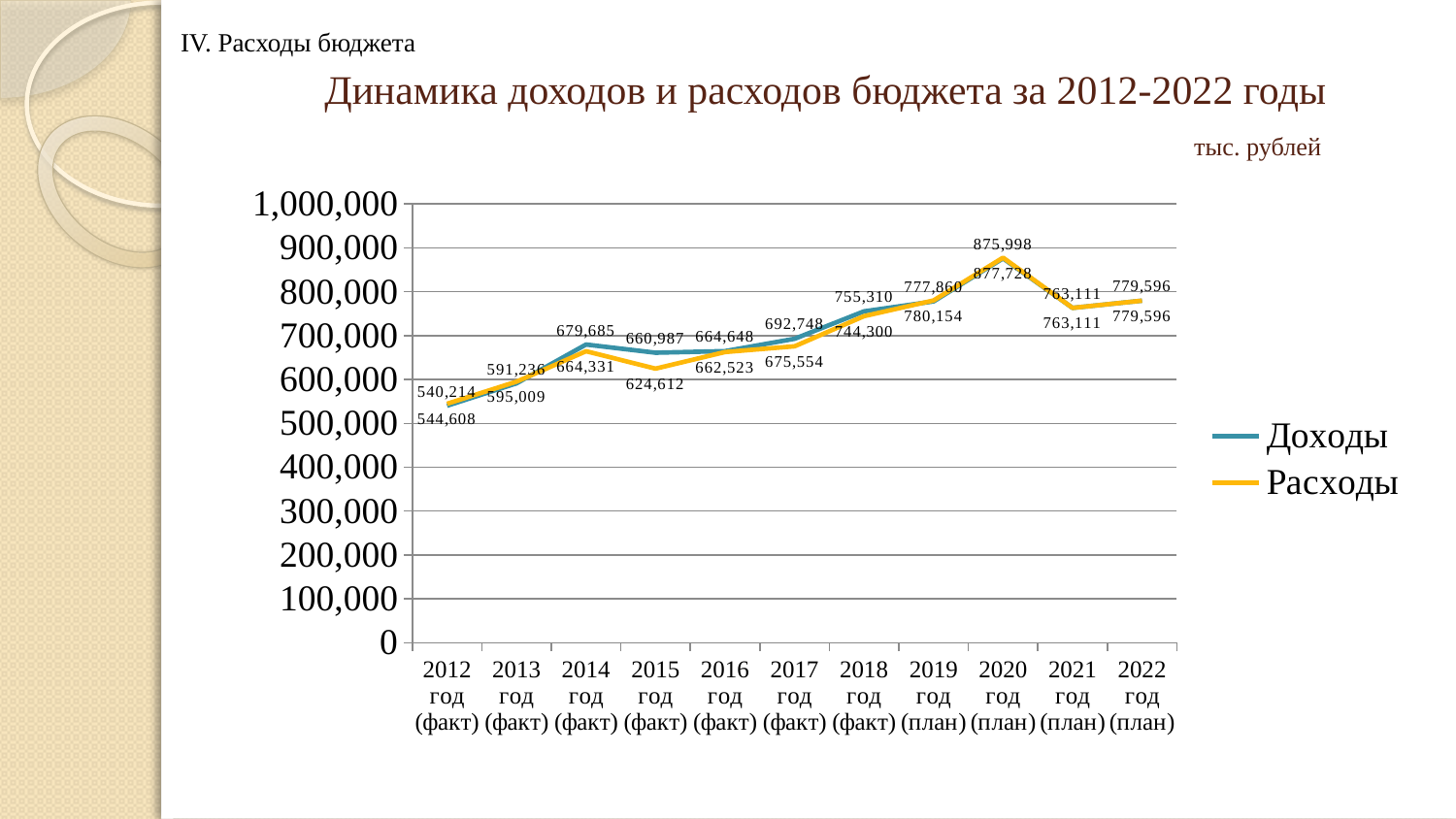
What type of chart is shown on the slide? Line chart What is the value of Доходы for 2015 год (факт)? 660,987 What is the value of Доходы for 2014 год (факт)? 679,685 How many series does the legend list? 2 What is the value of Расходы for 2021 год (план)? 763,111 What unit of measurement is stated for the chart values? тыс. рублей In which year is Доходы highest? 2020 год (план) What is the difference between Доходы and Расходы in 2015 год (факт)? 36,375 What is the value of Расходы for 2015 год (факт)? 624,612 How many years (data points) are plotted along the x axis? 11 Which is larger in 2014 год (факт), Доходы or Расходы? Доходы In which year is Расходы lowest? 2012 год (факт)